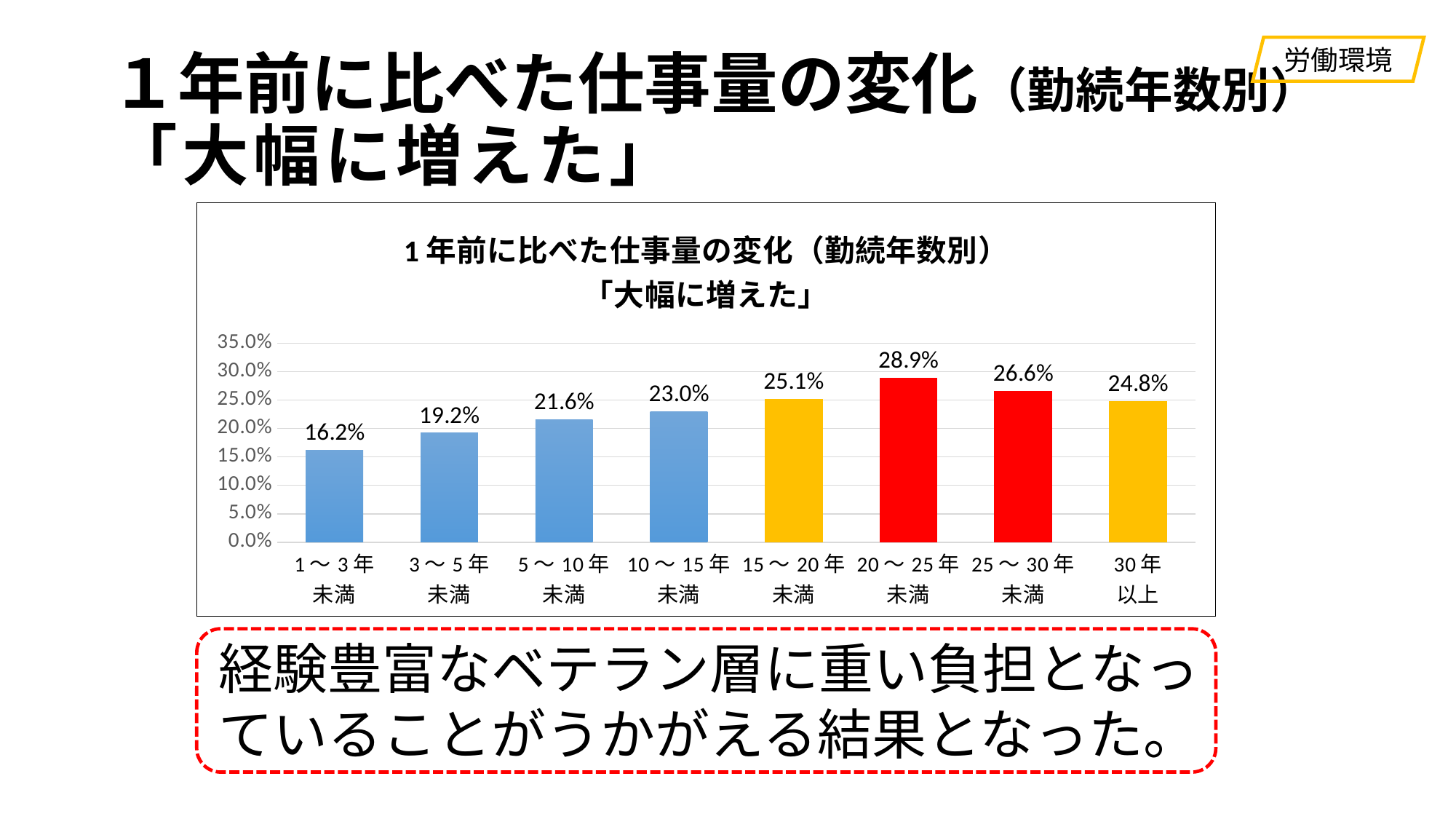
What is the value for 20～25年未満? 28.9% Which category has the highest value? 20～25年未満 What colour are the bars for 20～25年未満 and 25～30年未満? red Which category has the lowest value? 1～3年未満 How many categories are shown on the x axis? 8 Which is larger, the value for 25～30年未満 or the value for 15～20年未満? 25～30年未満 What is the value for 30年以上? 24.8% Is the value for 10～15年未満 greater or less than 25.0%? less What is the difference between the values for 20～25年未満 and 1～3年未満? 12.7% What is the value for 1～3年未満? 16.2% Do the values rise or fall from 1～3年未満 to 20～25年未満? rise What kind of chart is shown? bar chart